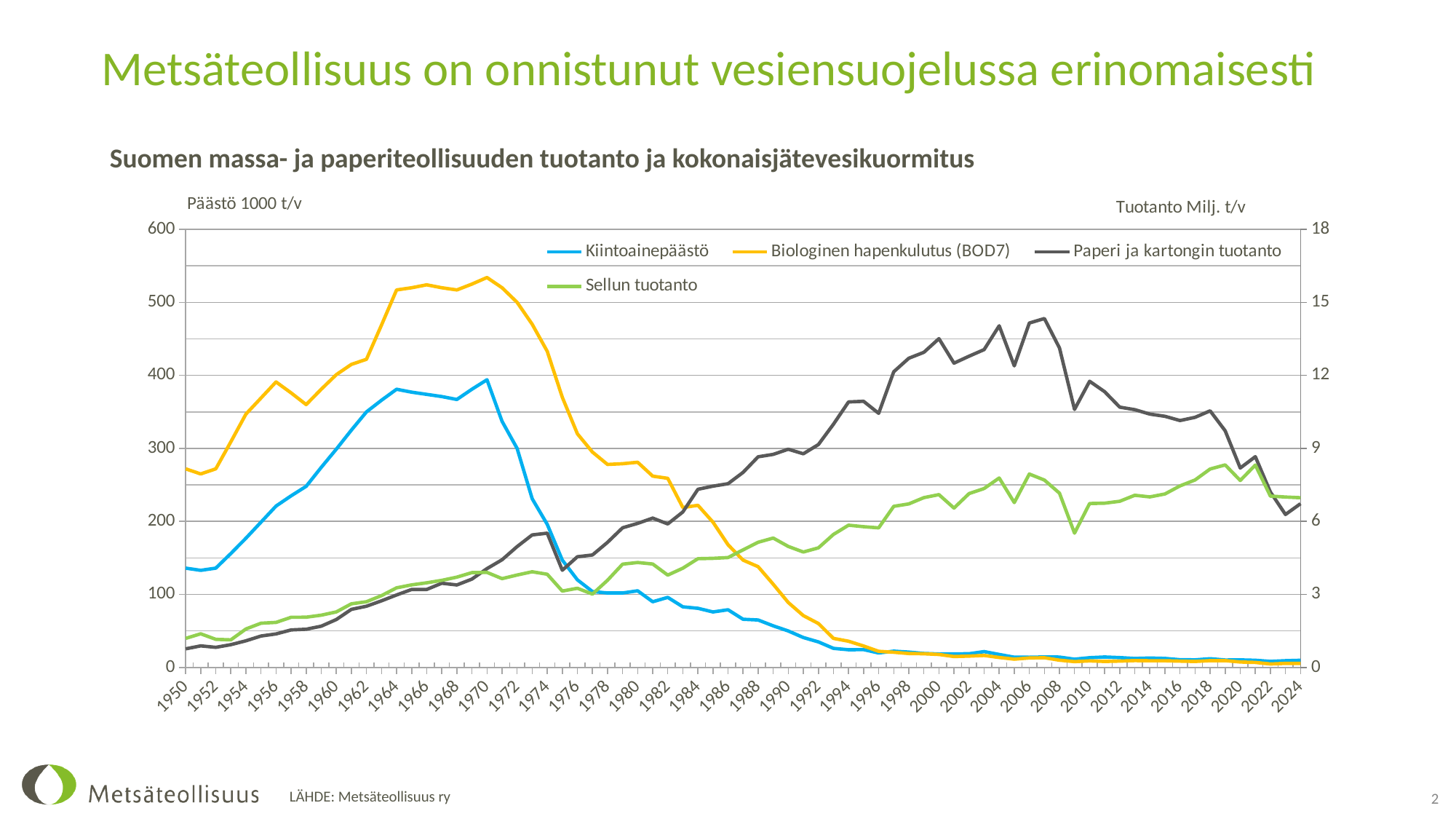
Does the Biologinen hapenkulutus (BOD7) line rise or fall from 1970 to 2024? fall What is the label of the left vertical axis? Päästö 1000 t/v Is the value for Kiintoainepäästö in 2024 greater or less than 100? less Which series reaches the highest value on the left axis (Päästö 1000 t/v)? Biologinen hapenkulutus (BOD7) How many series does the chart's legend list? 4 Does the Paperi ja kartongin tuotanto line rise or fall from 1950 to 2006? rise In 2006, which is higher: Paperi ja kartongin tuotanto or Sellun tuotanto? Paperi ja kartongin tuotanto What is the title of the chart? Suomen massa- ja paperiteollisuuden tuotanto ja kokonaisjätevesikuormitus In 1964, which is higher: Biologinen hapenkulutus (BOD7) or Kiintoainepäästö? Biologinen hapenkulutus (BOD7) Is the value for Kiintoainepäästö in 1970 greater or less than 300? greater What kind of chart is shown on the slide? line chart Is the value for Biologinen hapenkulutus (BOD7) in 1970 greater or less than 500? greater